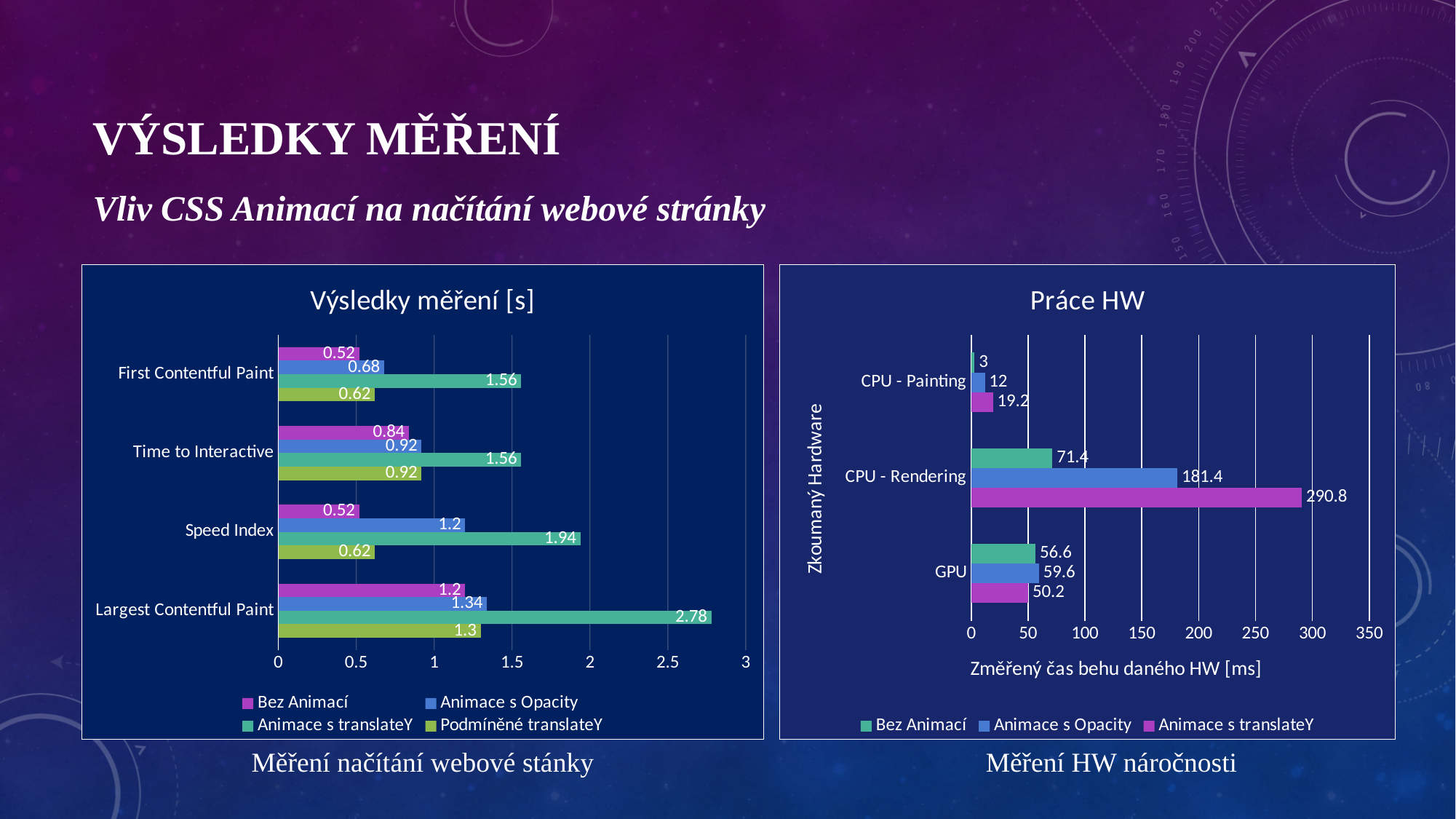
In the chart titled "Výsledky měření [s]", which category has the highest value for Animace s translateY? Largest Contentful Paint In the chart titled "Práce HW", what is the value for Bez Animací at CPU - Painting? 3 In the chart titled "Výsledky měření [s]", what is the difference between Animace s translateY and Bez Animací at First Contentful Paint? 1.04 In the chart titled "Výsledky měření [s]", how many series does the legend list? 4 In the chart titled "Výsledky měření [s]", what is the value for Animace s translateY at Largest Contentful Paint? 2.78 In the chart titled "Práce HW", what is the difference between Animace s Opacity and Bez Animací at CPU - Rendering? 110 In the chart titled "Práce HW", which series has the lowest value at GPU? Animace s translateY In the chart titled "Práce HW", what is the value for Animace s translateY at CPU - Rendering? 290.8 What kind of chart is the chart titled "Práce HW"? Bar chart In the chart titled "Výsledky měření [s]", what is the value for Bez Animací at Speed Index? 0.52 In the chart titled "Výsledky měření [s]", what is the value for Podmíněné translateY at Time to Interactive? 0.92 In the chart titled "Práce HW", how many categories are shown on the vertical axis? 3